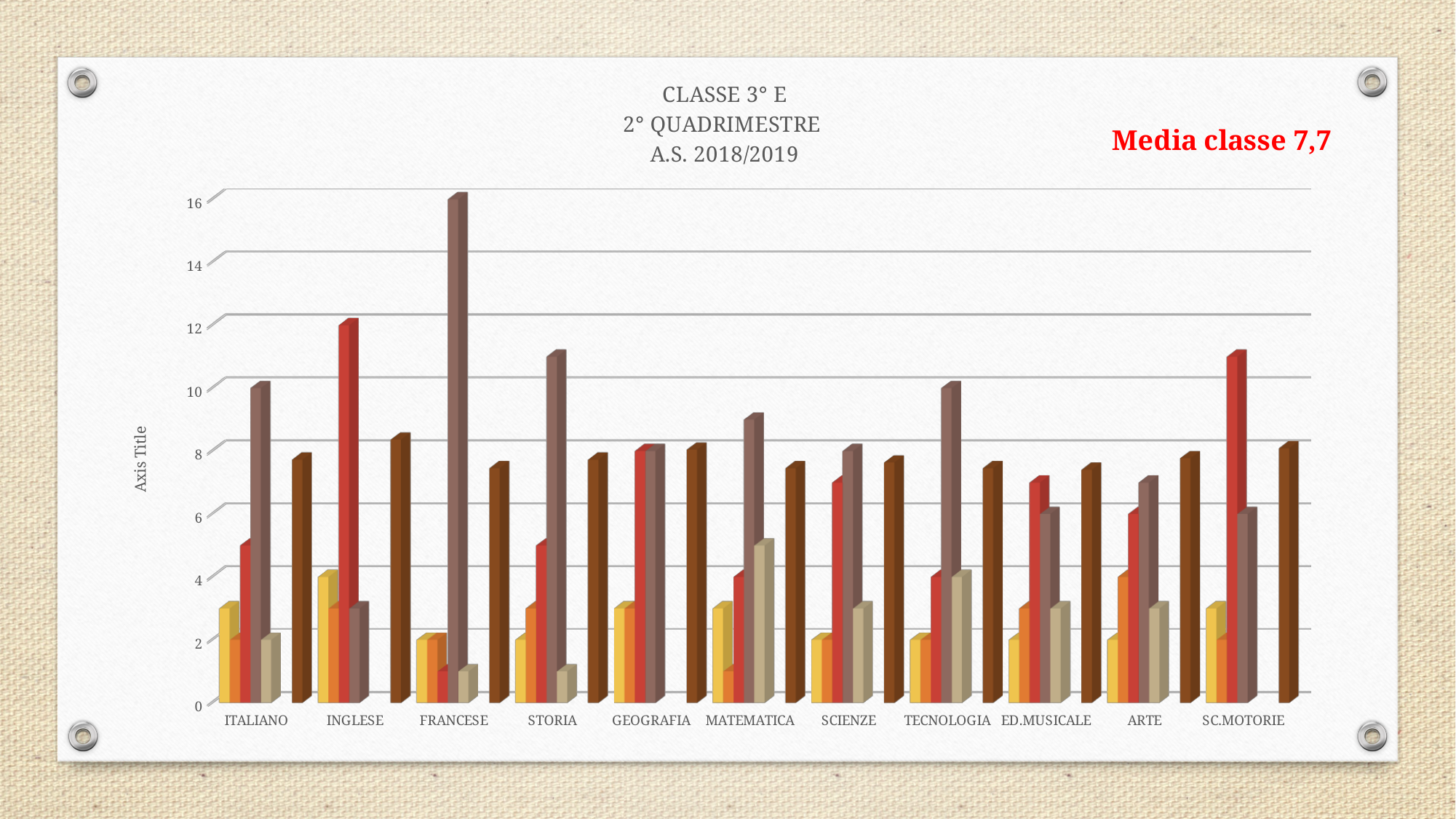
Is the tallest bar for FRANCESE greater or less than 14? greater What is the title of the chart? CLASSE 3° E 2° QUADRIMESTRE A.S. 2018/2019 Is the tallest bar for INGLESE greater or less than 10? greater Which category has a taller maximum bar, FRANCESE or INGLESE? FRANCESE What kind of chart is shown on the slide? bar chart Is the tallest bar for SC.MOTORIE greater or less than 10? greater Which subject category contains the tallest bar in the chart? FRANCESE How many subject categories are shown on the x axis of the chart? 11 Which category has a taller maximum bar, STORIA or ITALIANO? STORIA What is the class average (Media classe) stated on the slide? 7,7